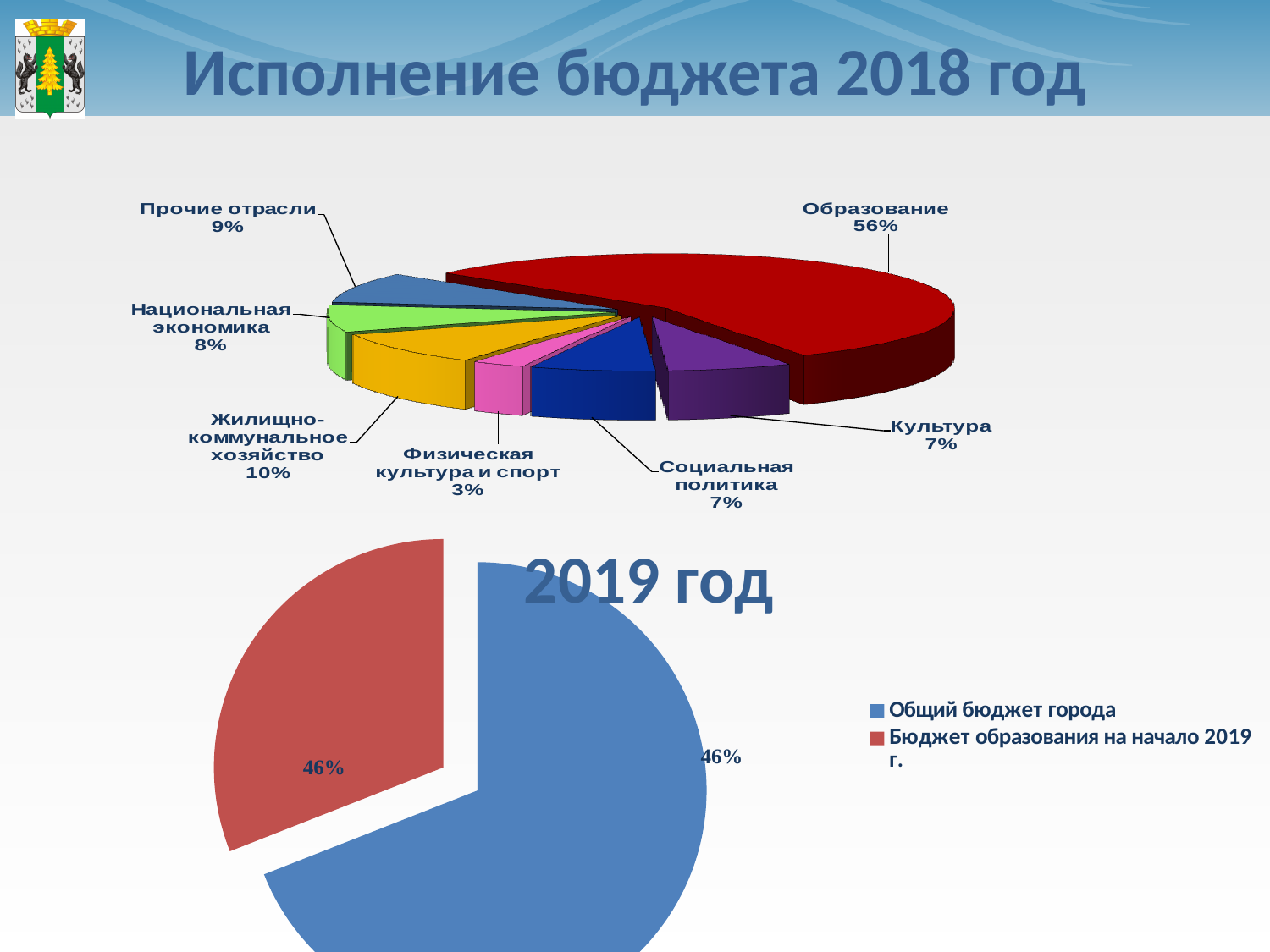
In the top chart (2018 год), what share does Образование have? 56% What kind of chart is the top chart (2018 год)? Pie chart In the top chart (2018 год), what share does Национальная экономика have? 8% How many categories are shown in the top chart (2018 год)? 7 In the top chart (2018 год), which is larger: Прочие отрасли or Национальная экономика? Прочие отрасли How many entries does the legend of the bottom chart (2019 год) list? 2 In the top chart (2018 год), what is the difference between the shares of Образование and Жилищно-коммунальное хозяйство? 46% In the top chart (2018 год), which category has the largest share? Образование In the top chart (2018 год), what share does Жилищно-коммунальное хозяйство have? 10% In the top chart (2018 год), which category has the smallest share? Физическая культура и спорт In the top chart (2018 год), what share does Физическая культура и спорт have? 3% In the bottom chart (2019 год), which legend entry is shown in red? Бюджет образования на начало 2019 г.